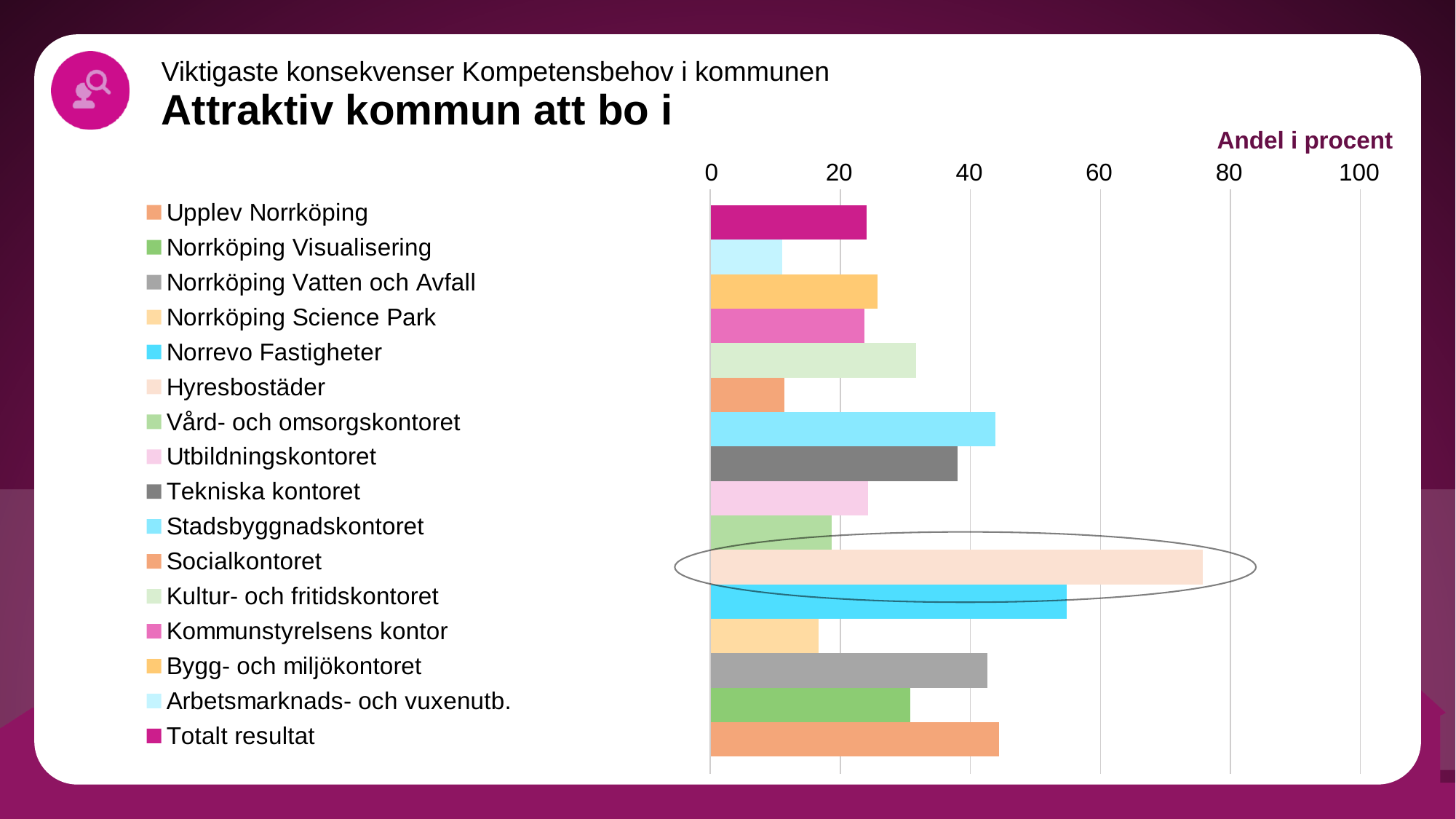
Is the value for Stadsbyggnadskontoret greater or less than 40? greater Is the value for Arbetsmarknads- och vuxenutb. greater or less than 20? less How many series does the legend list? 16 Is the value for Kultur- och fritidskontoret greater or less than 40? less Which is larger, the value for Hyresbostäder or the value for Stadsbyggnadskontoret? Hyresbostäder How many bars are plotted in the chart? 16 What kind of chart is shown on the slide? bar chart Which series has the highest value in the chart? Hyresbostäder Which is larger, the value for Kultur- och fritidskontoret or the value for Socialkontoret? Kultur- och fritidskontoret What is the axis title shown above the value axis of the chart? Andel i procent